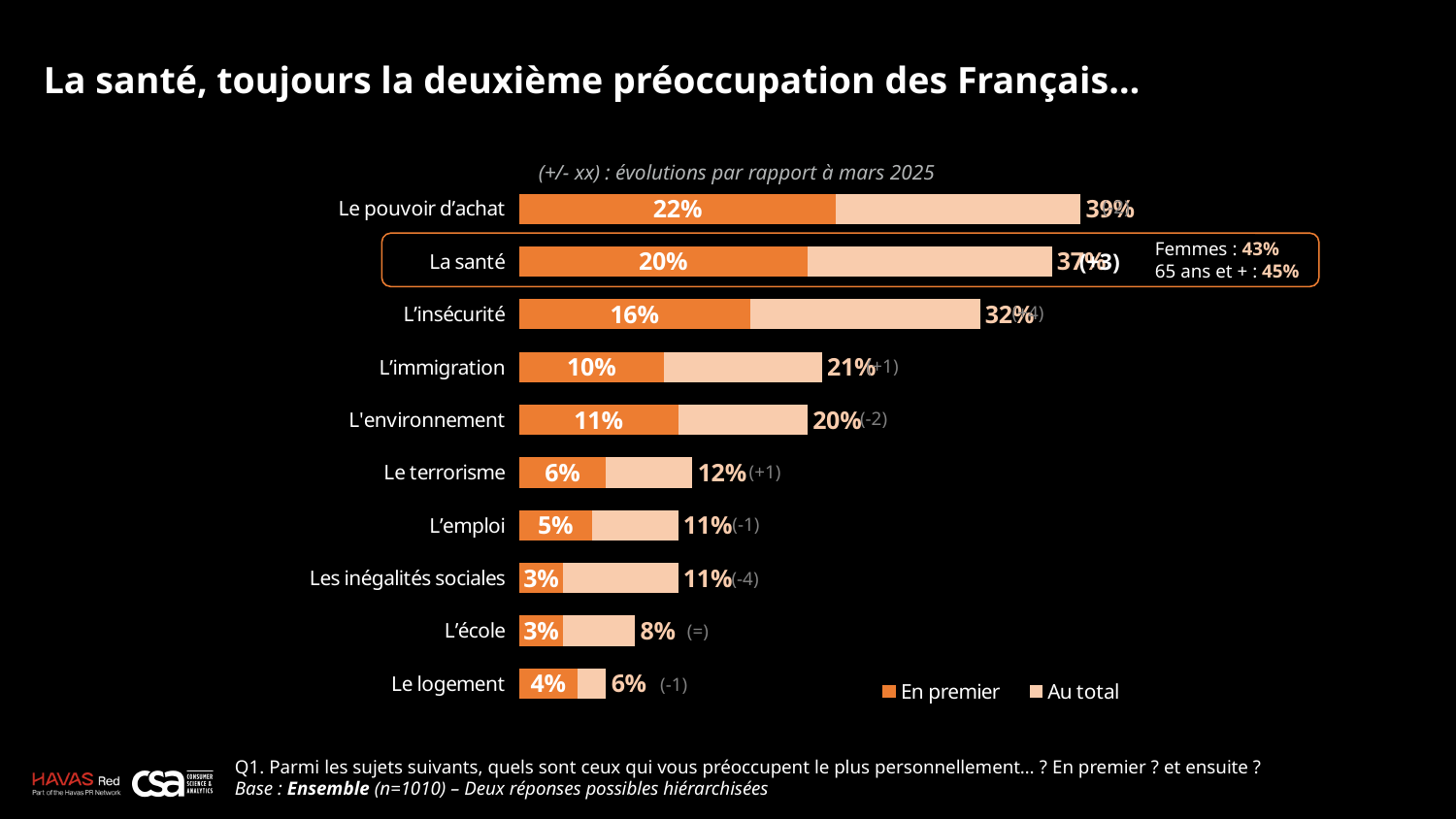
Which category has the lowest 'Au total' value? Le logement What is the 'Au total' value for La santé? 37% Which category has the highest 'Au total' value? Le pouvoir d'achat How many categories are shown in the chart? 10 How many series does the legend list? 2 What is the 'En premier' value for L'insécurité? 16% Which is larger, the 'En premier' value for L'immigration or for L'environnement? L'environnement What kind of chart is shown on the slide? Bar chart What is the 'Au total' value for Le terrorisme? 12% What is the 'En premier' value for Le pouvoir d'achat? 22% What is the difference between the 'Au total' values for Le pouvoir d'achat and La santé? 2% What are the two series named in the legend? En premier and Au total